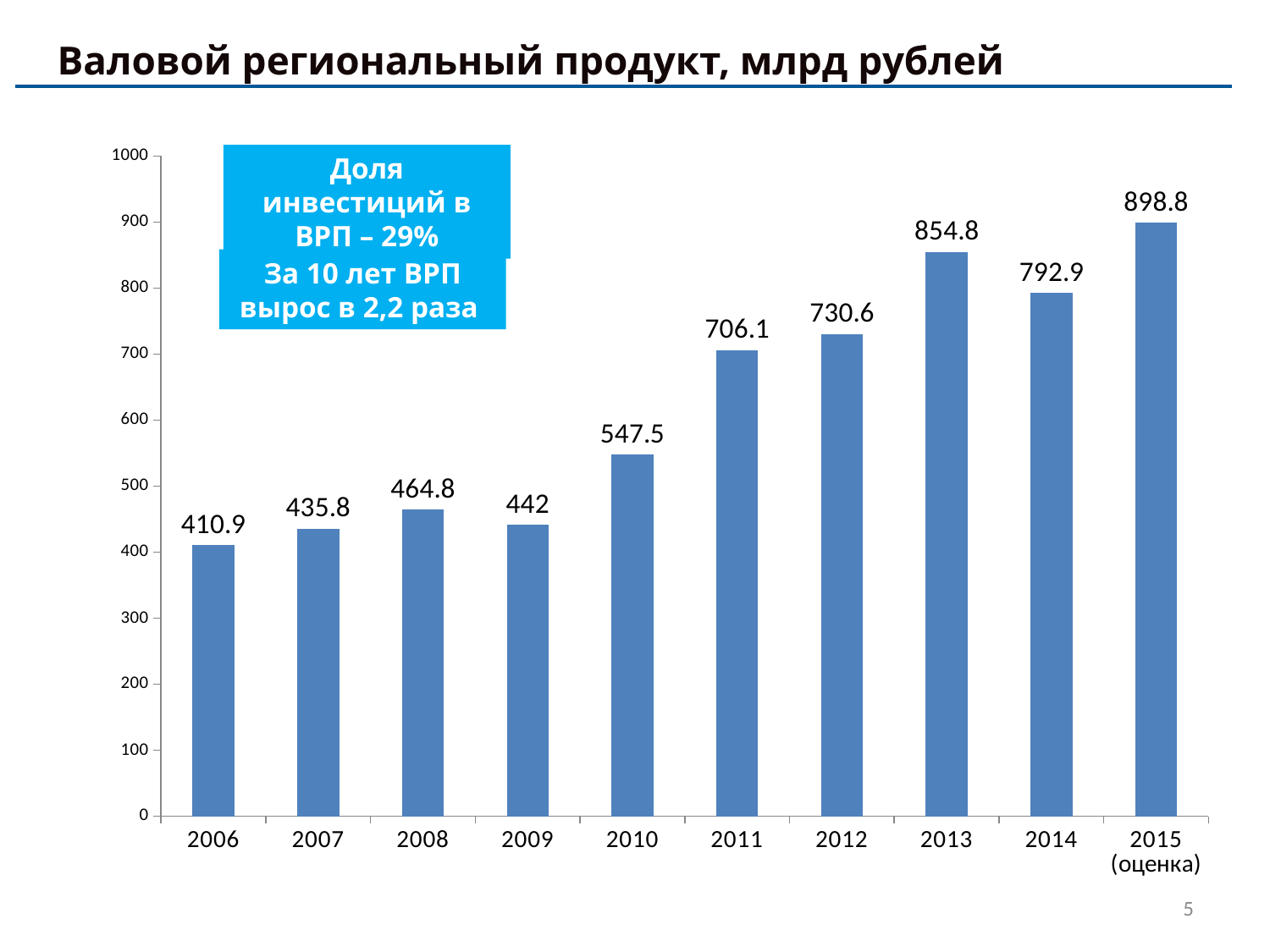
What kind of chart is shown on the slide? bar chart What is the value for 2006? 410.9 What is the value for 2010? 547.5 Which year has the lowest value? 2006 Which is larger, the value for 2008 or the value for 2009? 2008 How many years are shown on the x axis? 10 Which year has the highest value? 2015 (оценка) What is the title of the chart? Валовой региональный продукт, млрд рублей What is the difference between the values for 2011 and 2010? 158.6 What is the value for 2013? 854.8 Is the value for 2012 greater or less than 700? greater What is the difference between the values for 2015 (оценка) and 2014? 105.9